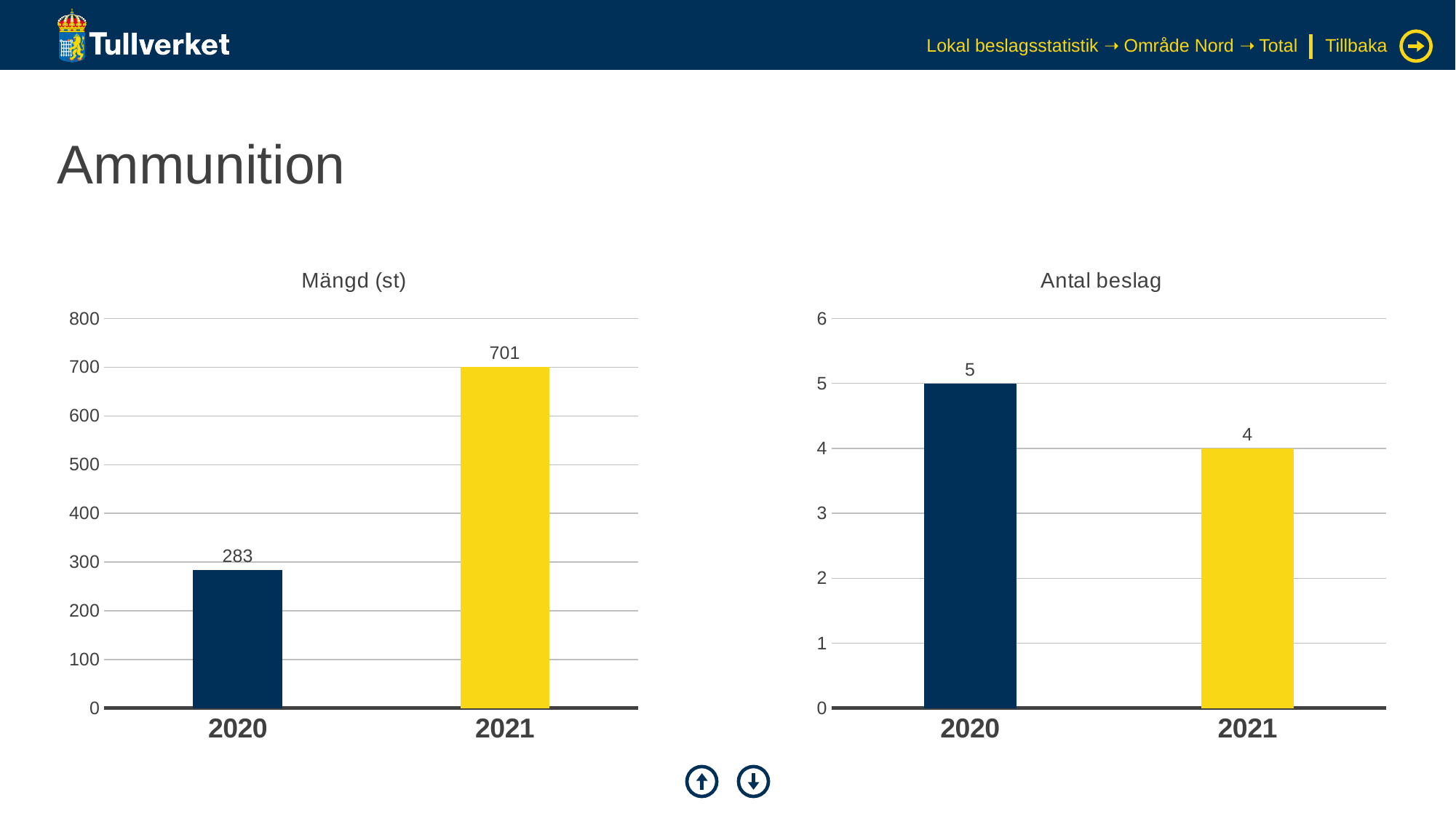
In the 'Antal beslag' chart, which year has the lowest value? 2021 How many categories are shown in the 'Antal beslag' chart? 2 What kind of chart is the 'Mängd (st)' chart? bar chart In the 'Mängd (st)' chart, what is the value for 2021? 701 In the 'Mängd (st)' chart, do the values rise or fall from 2020 to 2021? rise In the 'Antal beslag' chart, what is the value for 2021? 4 In the 'Mängd (st)' chart, what is the value for 2020? 283 In the 'Antal beslag' chart, what is the value for 2020? 5 In the 'Antal beslag' chart, which is larger, the value for 2020 or 2021? 2020 In the 'Antal beslag' chart, what is the difference between the values for 2020 and 2021? 1 In the 'Mängd (st)' chart, what is the difference between the values for 2021 and 2020? 418 In the 'Mängd (st)' chart, which year has the highest value? 2021